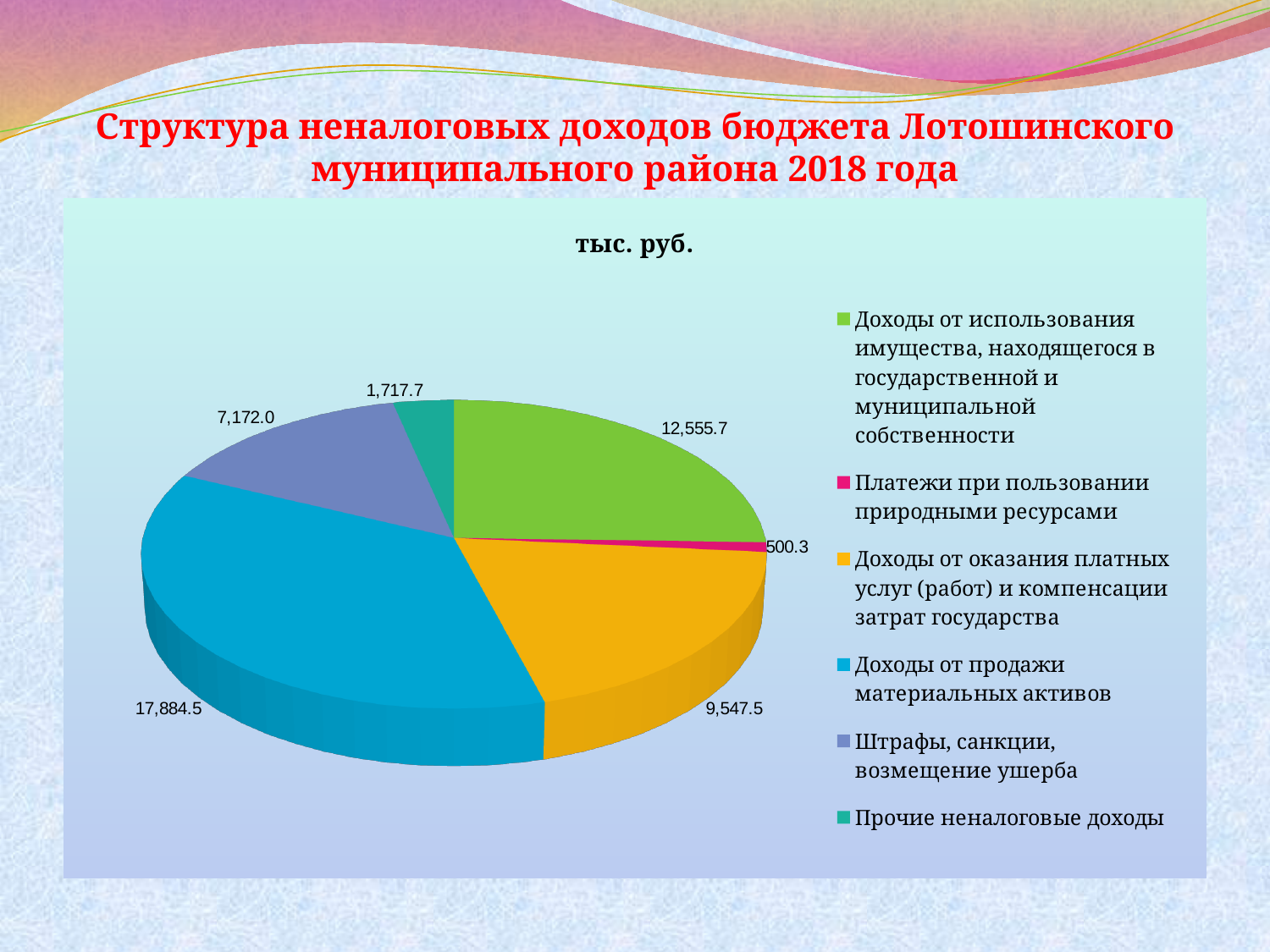
What is the value for Доходы от продажи материальных активов? 17,884.5 What is the value for Доходы от использования имущества, находящегося в государственной и муниципальной собственности? 12,555.7 What is the difference between the values for Доходы от оказания платных услуг (работ) и компенсации затрат государства and Штрафы, санкции, возмещение ущерба? 2,375.5 What is the difference between the values for Доходы от продажи материальных активов and Доходы от использования имущества, находящегося в государственной и муниципальной собственности? 5,328.8 What is the title of the chart? тыс. руб. What is the value for Платежи при пользовании природными ресурсами? 500.3 Which category has the smallest slice of the pie? Платежи при пользовании природными ресурсами Which is larger: the value for Прочие неналоговые доходы or the value for Платежи при пользовании природными ресурсами? Прочие неналоговые доходы How many categories does the pie chart have? 6 Which category has the largest slice of the pie? Доходы от продажи материальных активов What is the value for Штрафы, санкции, возмещение ущерба? 7,172.0 What kind of chart is shown on the slide? Pie chart